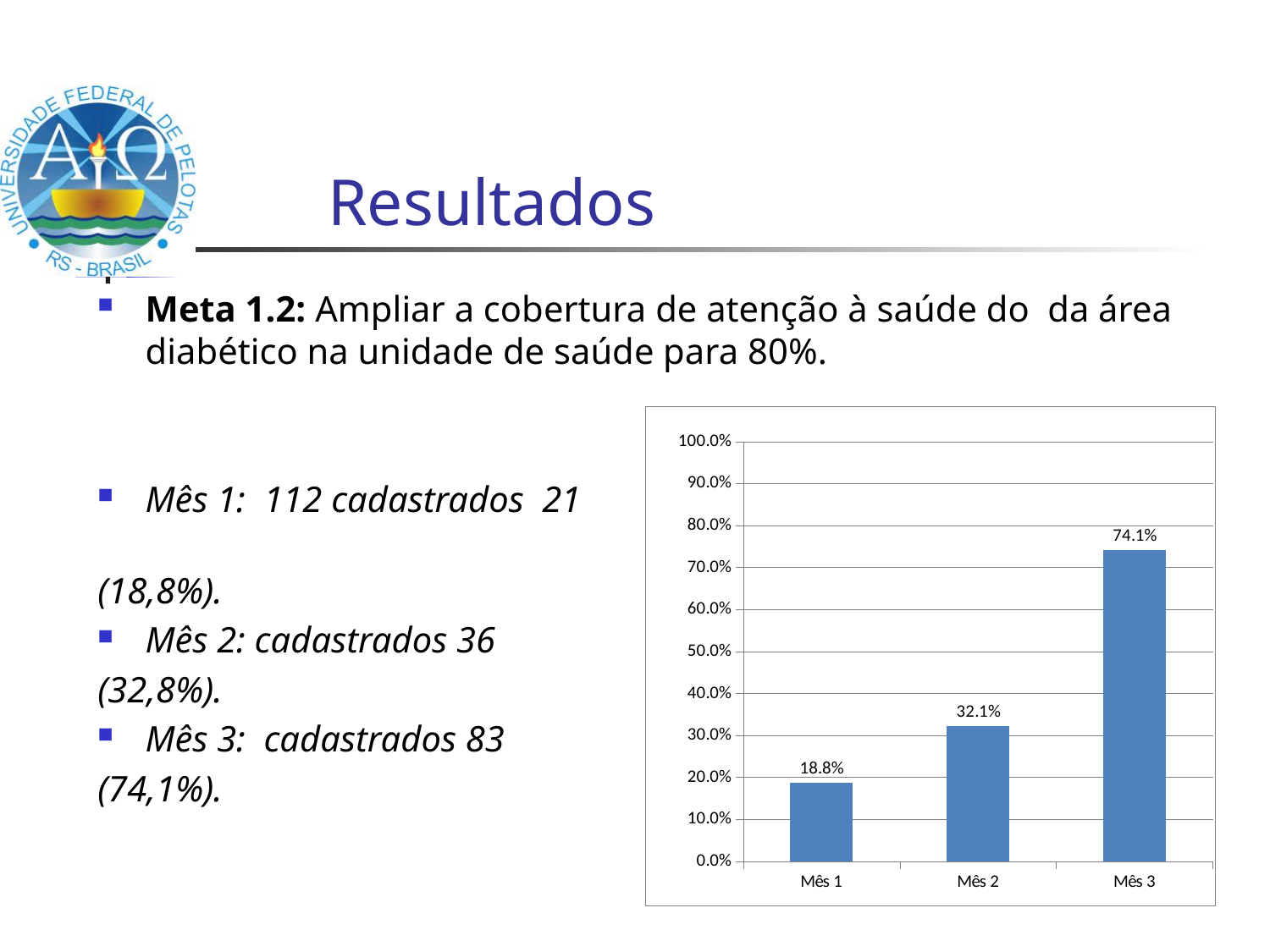
What is the value for Mês 1? 18.8% Which is larger, the value for Mês 1 or the value for Mês 2? Mês 2 What is the value for Mês 2? 32.1% What is the difference between the values for Mês 3 and Mês 2? 42.0% What is the difference between the values for Mês 2 and Mês 1? 13.3% Do the values rise or fall from Mês 1 to Mês 3? rise Which month has the lowest value? Mês 1 What kind of chart is shown on the slide? bar chart Which month has the highest value? Mês 3 What is the value for Mês 3? 74.1% How many categories are shown on the x axis? 3 Is the value for Mês 3 greater or less than 80.0%? less